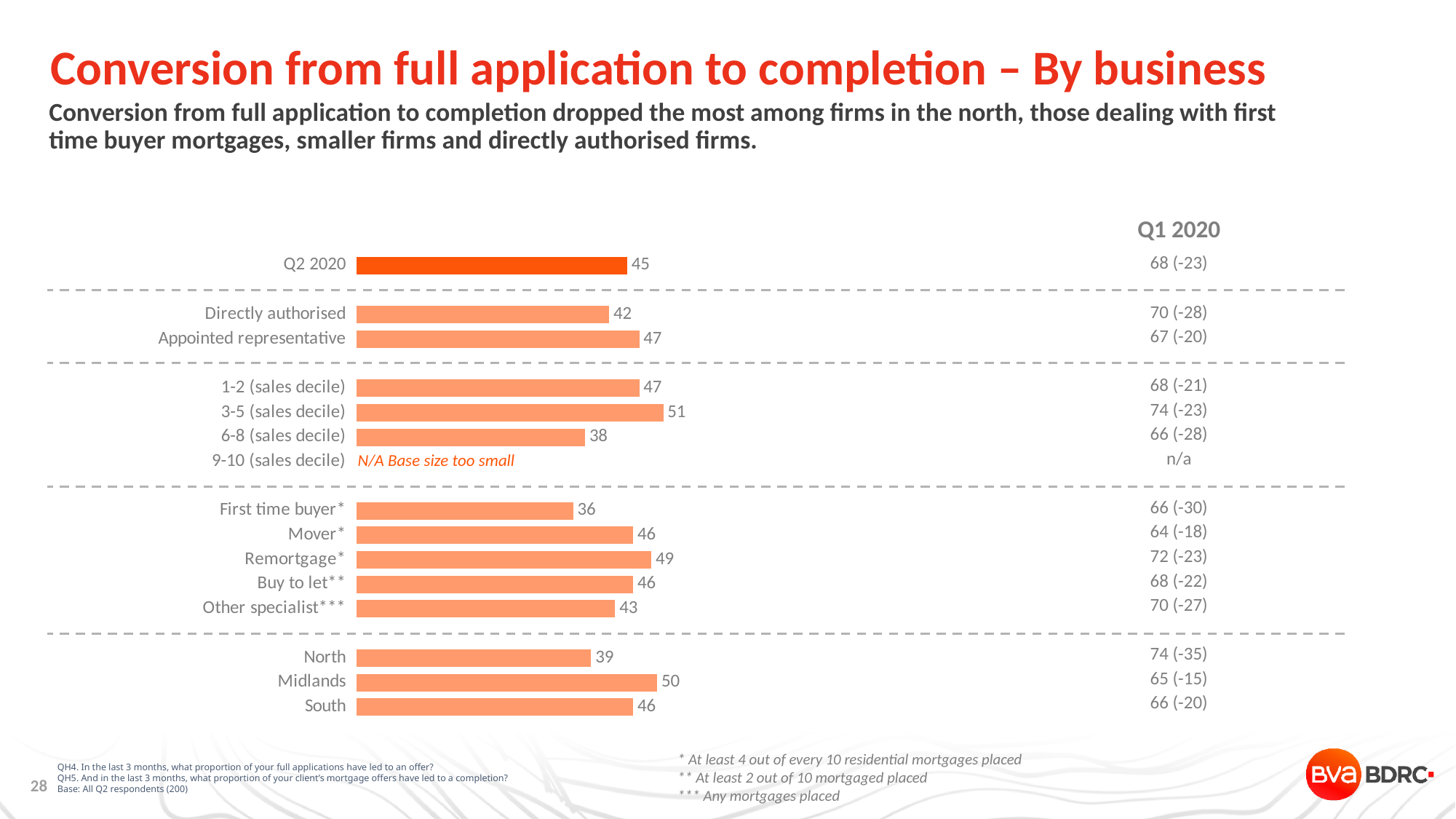
How many regions (North, Midlands, South) are plotted in the chart? 3 What is the value for Midlands? 50 Which category has the lowest value in the chart? First time buyer What is the value for First time buyer? 36 Which category has the highest value in the chart? 3-5 (sales decile) What is shown for the 9-10 (sales decile) category instead of a bar? N/A Base size too small Which is larger, the value for North or the value for South? South What kind of chart is shown on the slide? Bar chart What is the difference between the values for Appointed representative and Directly authorised? 5 What is the Q1 2020 value shown for North? 74 (-35) What is the value for Q2 2020 overall? 45 What is the difference between the values for Midlands and North? 11